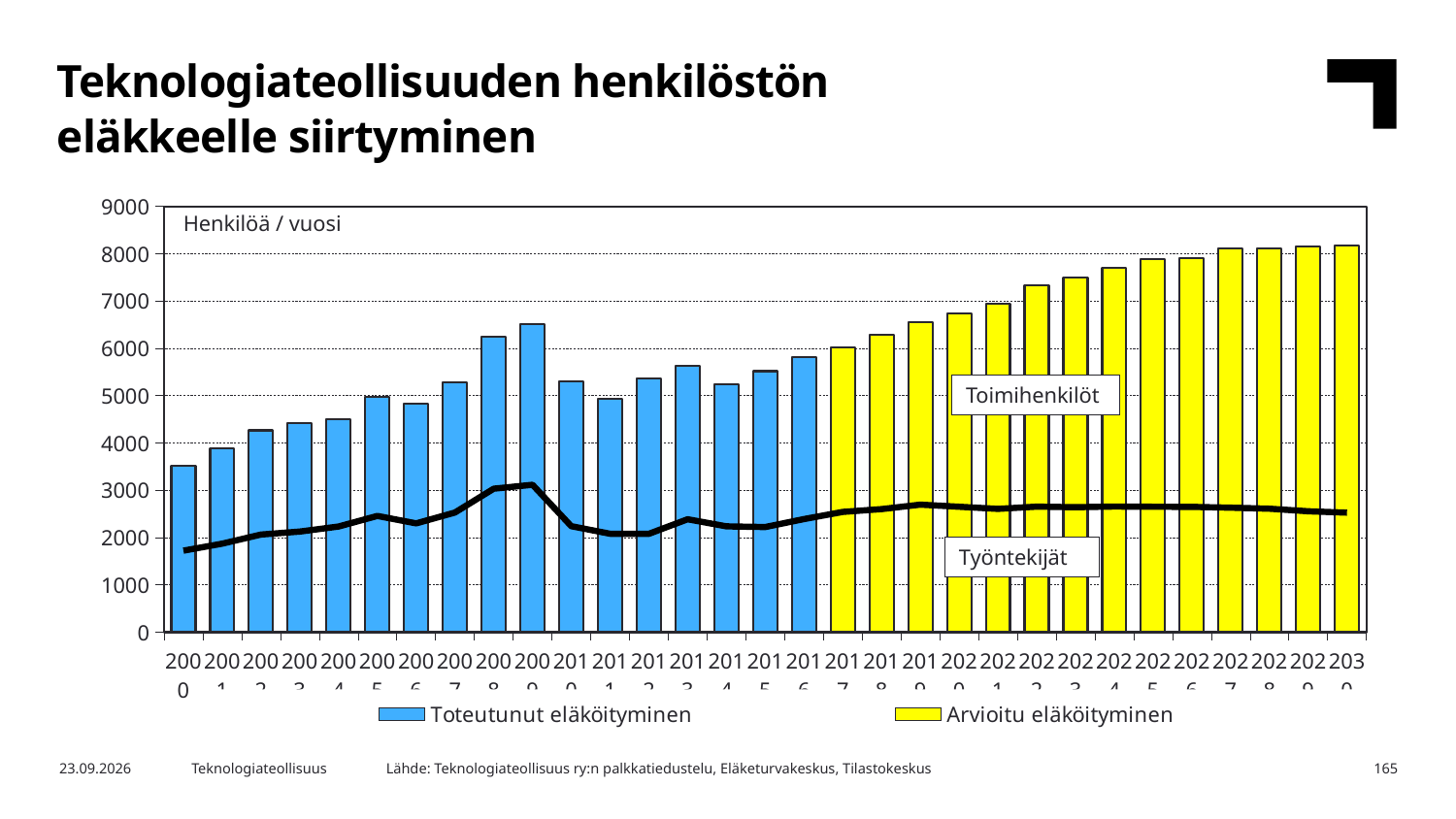
Which bar is larger, 2009 or 2010? 2009 Among the blue 'Toteutunut eläköityminen' bars, which year is highest? 2009 Which year has the lowest bar? 2000 Is the bar for 2000 greater or less than 4000? less Is the bar for 2023 greater or less than 7000? greater Do the yellow 'Arvioitu eläköityminen' bars rise or fall from 2017 to 2030? rise How many years (bars) are plotted along the x axis? 31 How many series does the legend list? 2 Is the bar for 2009 greater or less than 6000? greater What unit label is shown at the top left inside the plot area? Henkilöä / vuosi What kind of chart is shown on the slide? bar and line chart